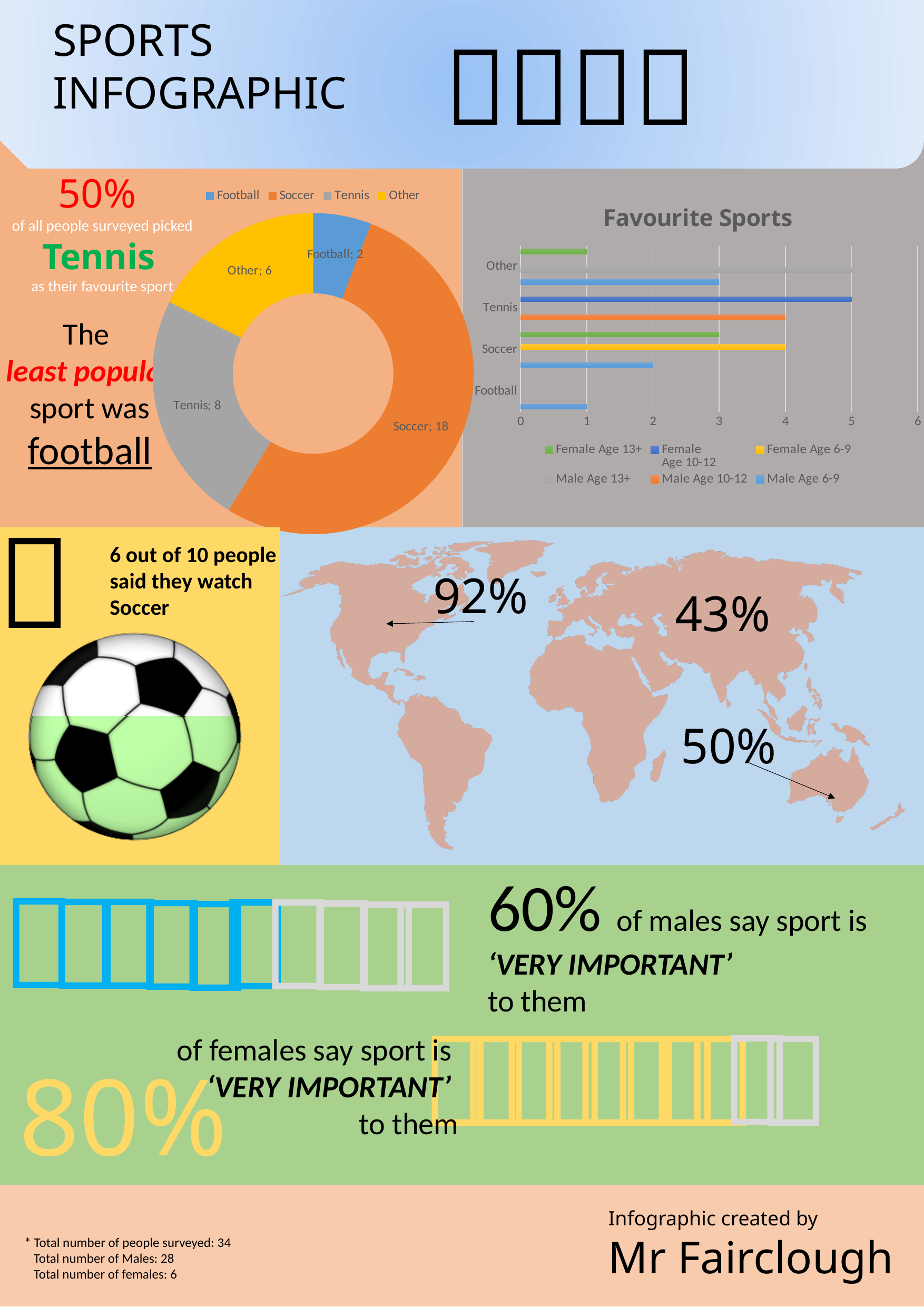
In the doughnut chart on the left, which category has the highest value? Soccer What is the title of the bar chart on the right? Favourite Sports In the doughnut chart on the left, which category has the lowest value? Football In the doughnut chart on the left, what is the value for Tennis? 8 How many categories does the doughnut chart on the left show? 4 In the Favourite Sports chart, for Soccer, which is larger: Female Age 6-9 or Male Age 6-9? Female Age 6-9 In the doughnut chart on the left, what is the difference between the values for Soccer and Tennis? 10 In the Favourite Sports chart, what is the value for Female Age 10-12 for Tennis? 5 How many series does the legend of the Favourite Sports chart list? 6 What kind of chart is the Favourite Sports chart? bar chart In the doughnut chart on the left, what is the value for Soccer? 18 In the Favourite Sports chart, what is the value for Male Age 6-9 for Football? 1